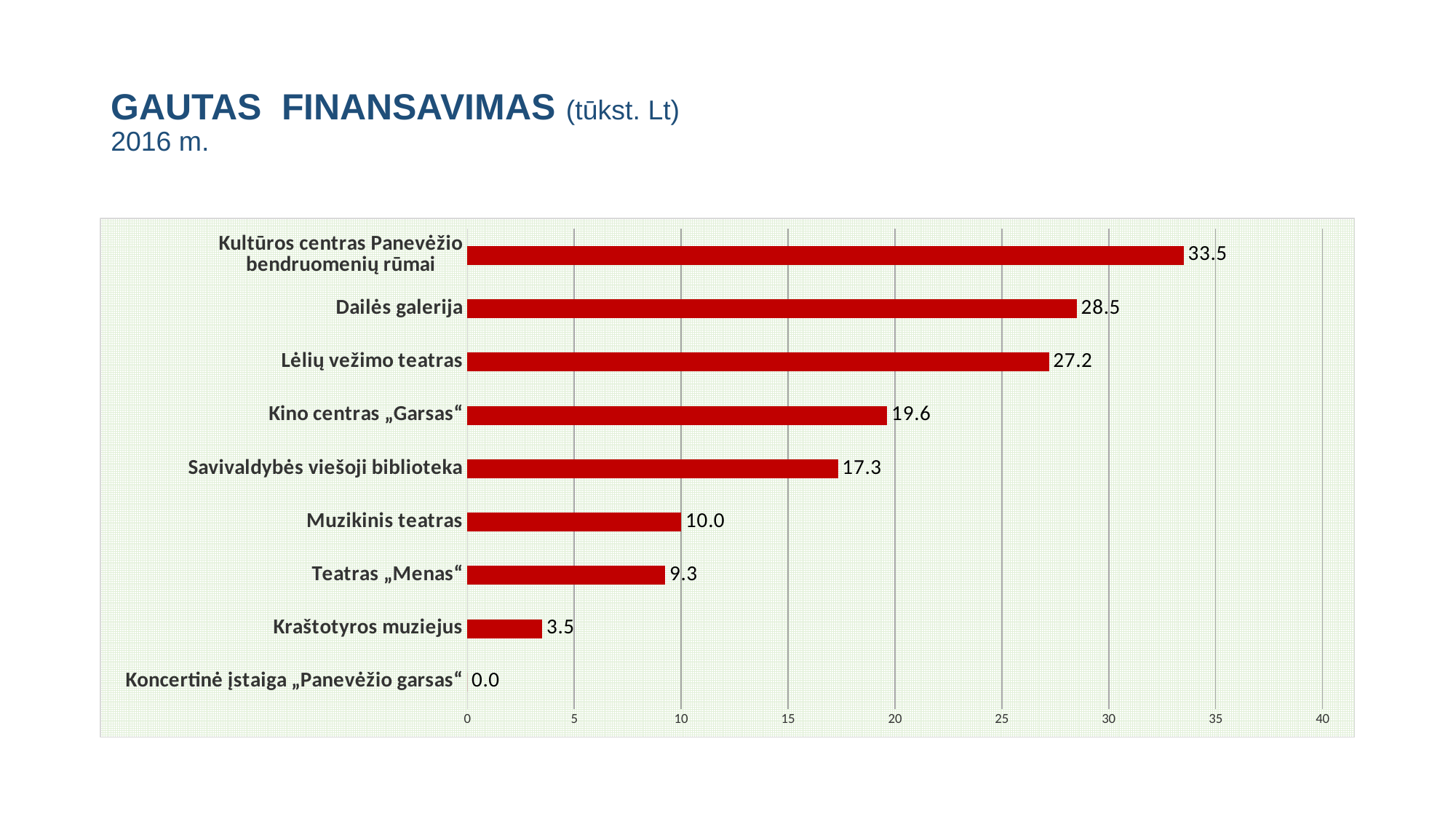
What is the value for Dailės galerija? 28.5 Which category has the lowest value? Koncertinė įstaiga „Panevėžio garsas“ How many categories are shown in the chart? 9 What is the difference between the values for Muzikinis teatras and Teatras „Menas“? 0.7 Which category has the highest value? Kultūros centras Panevėžio bendruomenių rūmai Is the value for Lėlių vežimo teatras greater or less than 25? greater Which is larger, the value for Savivaldybės viešoji biblioteka or the value for Kino centras „Garsas“? Kino centras „Garsas“ What is the value for Kraštotyros muziejus? 3.5 What is the value for Kino centras „Garsas“? 19.6 What unit is given in the slide title for the values? tūkst. Lt What kind of chart is shown on the slide? bar chart What is the difference between the values for Dailės galerija and Lėlių vežimo teatras? 1.3